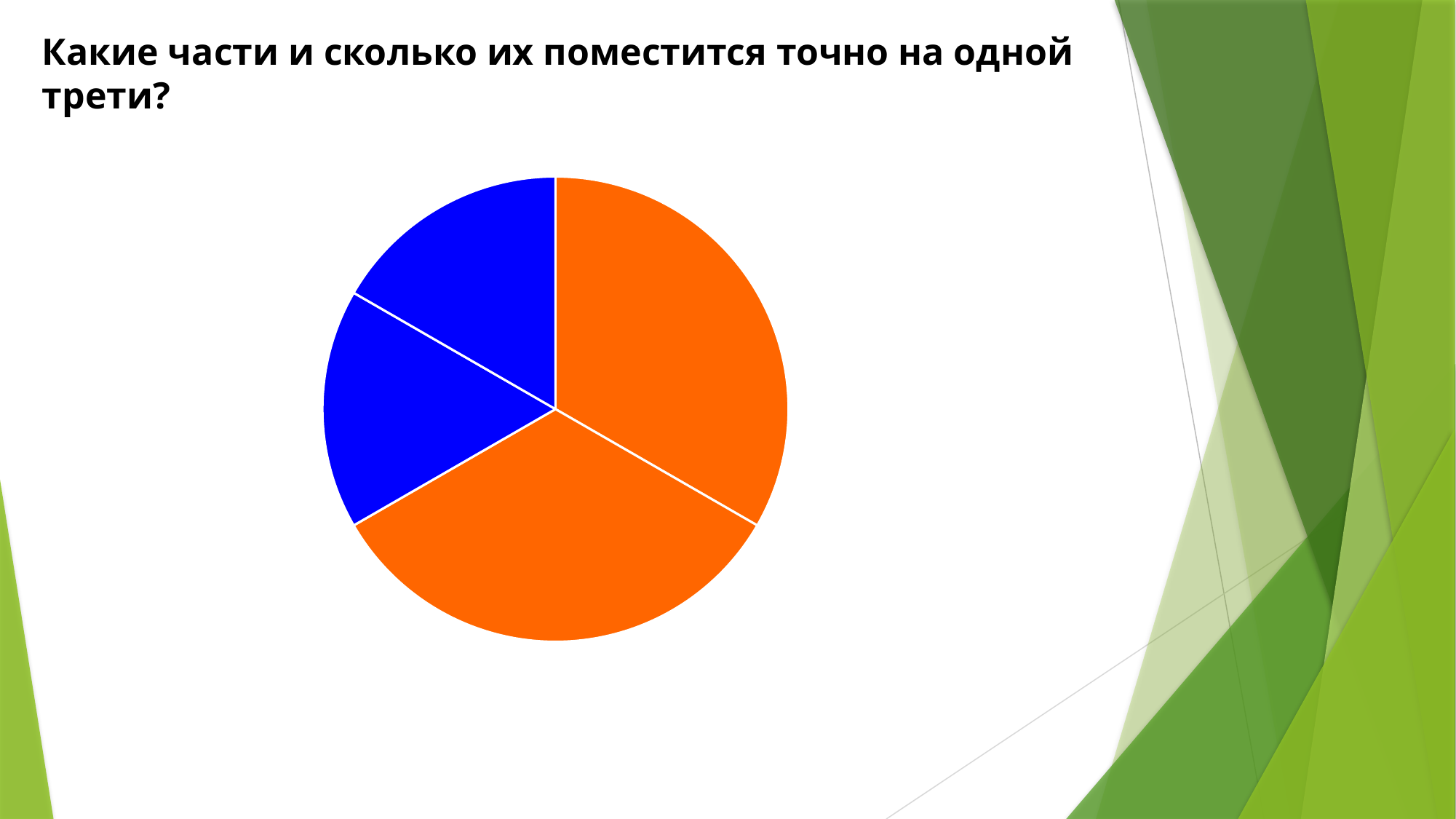
What kind of chart is shown on the slide? pie chart How many slices of the pie are blue? 2 Which two colours are used for the slices of the pie chart? orange and blue How many slices does the pie chart have? 4 Which colour covers a larger part of the pie, orange or blue? orange Does the pie chart have a legend? no How many slices of the pie are orange? 2